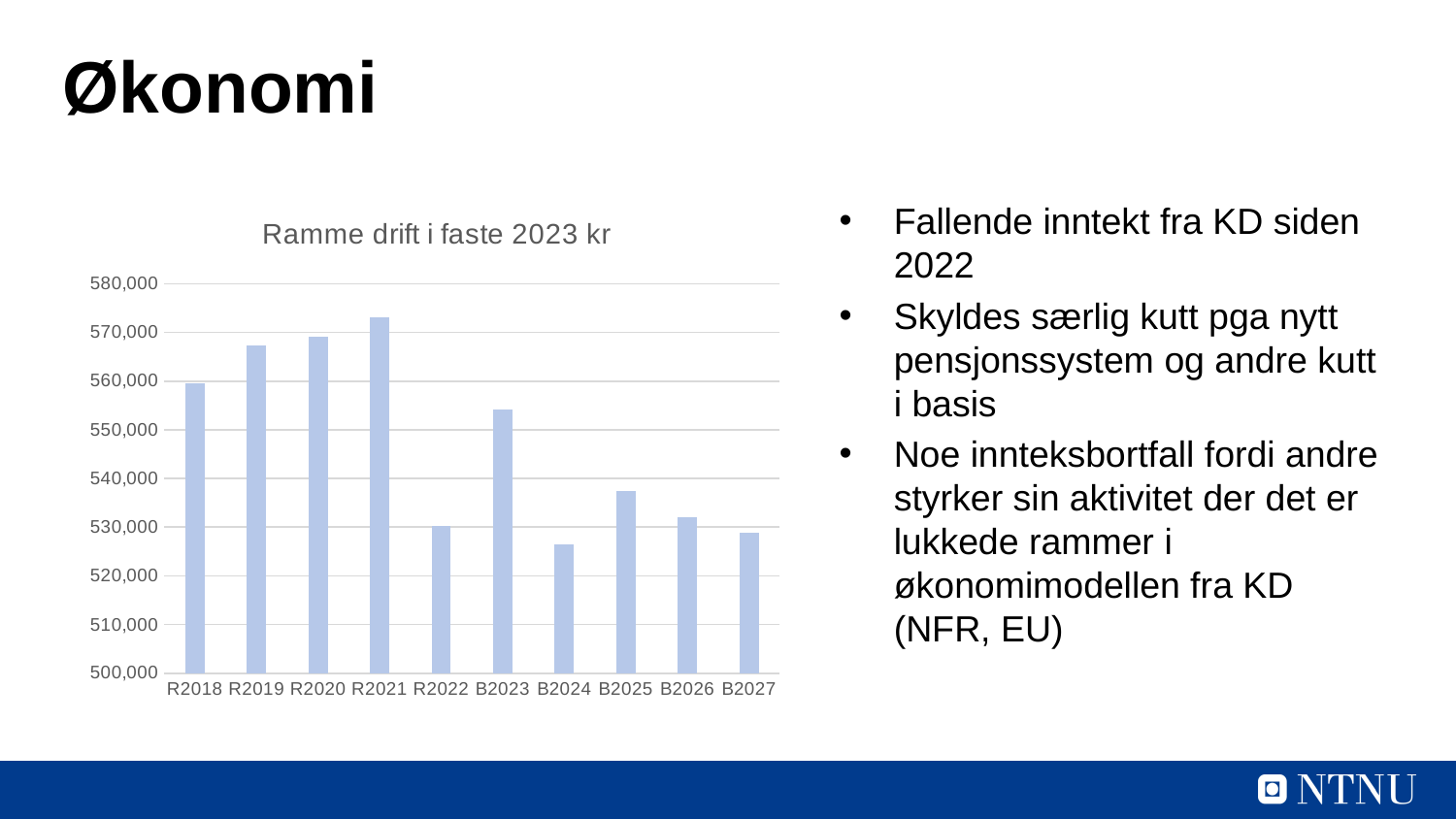
Which is larger, the value for R2019 or the value for R2022? R2019 Is the value for R2021 greater or less than 570,000? greater Which year has the highest value in the chart? R2021 Is the value for B2024 greater or less than 530,000? less How many categories (years) are shown on the x axis of the chart? 10 What kind of chart is shown on the slide? Bar chart Is the value for R2022 greater or less than 540,000? less Do the values rise or fall from R2021 to R2022? fall What is the title of the chart? Ramme drift i faste 2023 kr Which is larger, the value for B2023 or the value for B2025? B2023